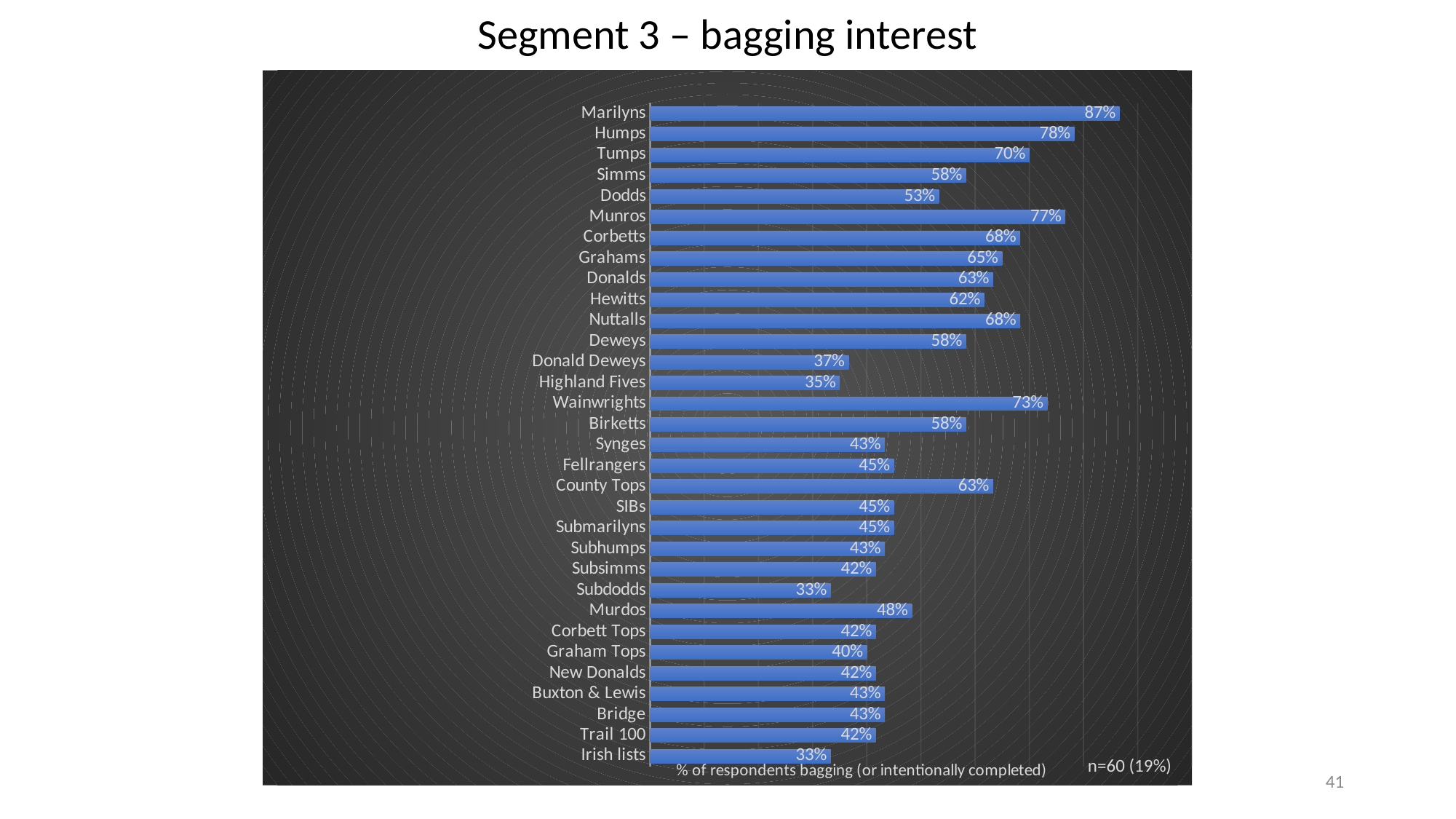
How many lists (categories) are shown in the chart? 32 What is the value for Murdos? 48% What is the value shown for Wainwrights? 73% What percentage is shown for Highland Fives? 35% Which list has the highest percentage of respondents bagging it? Marilyns Which has a larger value, Donald Deweys or County Tops? County Tops What is the sample size noted on the chart? n=60 (19%) What is the difference between the values for Humps and Tumps? 8% What is the difference between the values for Munros and Corbetts? 9% What type of chart is shown on the slide? Bar chart What percentage of respondents are bagging the Marilyns? 87% Which has a larger value, Simms or Dodds? Simms